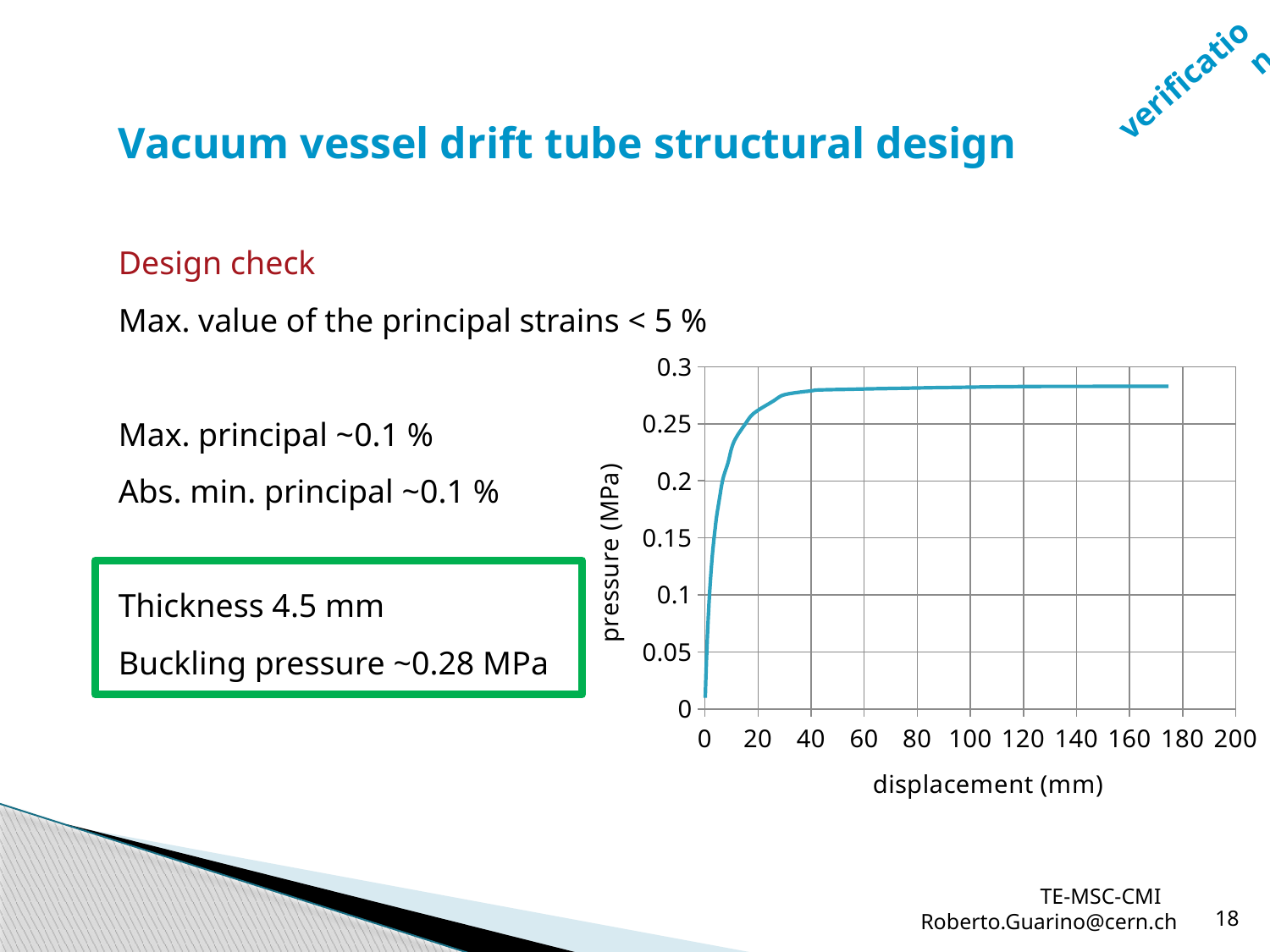
What kind of chart is shown on the slide? line chart Is the pressure at a displacement of 100 mm greater or less than 0.25 MPa? greater What is the label of the y axis of the chart? pressure (MPa) Is the pressure at a displacement of 40 mm greater or less than 0.15 MPa? greater What is the label of the x axis of the chart? displacement (mm) Does the pressure rise or fall as displacement increases along the x axis? rise Is the pressure at a displacement of 160 mm greater or less than 0.3 MPa? less How many lines (data series) are plotted on the chart? 1 What is the highest value shown on the x axis of the chart? 200